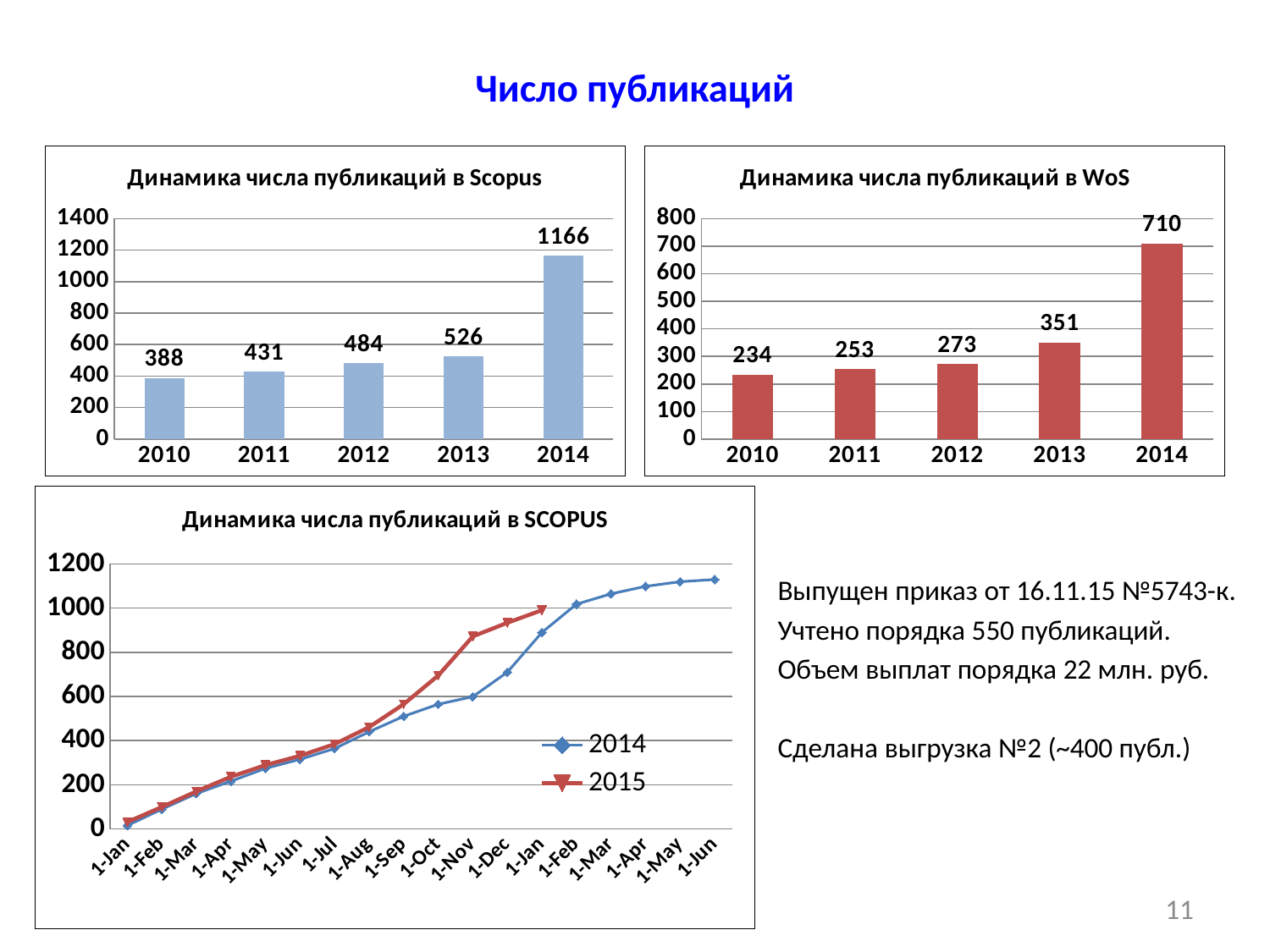
In the chart 'Динамика числа публикаций в WoS', which is larger, the value for 2012 or the value for 2013? 2013 In the chart 'Динамика числа публикаций в WoS', what is the value for 2013? 351 In the chart 'Динамика числа публикаций в Scopus', what is the value for 2014? 1166 In the chart 'Динамика числа публикаций в Scopus', which year has the lowest value? 2010 How many series does the legend of the chart 'Динамика числа публикаций в SCOPUS' (bottom left) list? 2 In the chart 'Динамика числа публикаций в WoS', what is the difference between the values for 2011 and 2010? 19 In the chart 'Динамика числа публикаций в Scopus', what is the difference between the values for 2014 and 2013? 640 How many years are shown in the chart 'Динамика числа публикаций в Scopus'? 5 In the chart 'Динамика числа публикаций в WoS', which year has the highest value? 2014 In the chart 'Динамика числа публикаций в Scopus', do the values rise or fall from 2010 to 2014? rise In the bottom-left chart 'Динамика числа публикаций в SCOPUS', is the value of the 2015 series at 1-Nov greater or less than 800? greater What type of chart is 'Динамика числа публикаций в WoS'? bar chart